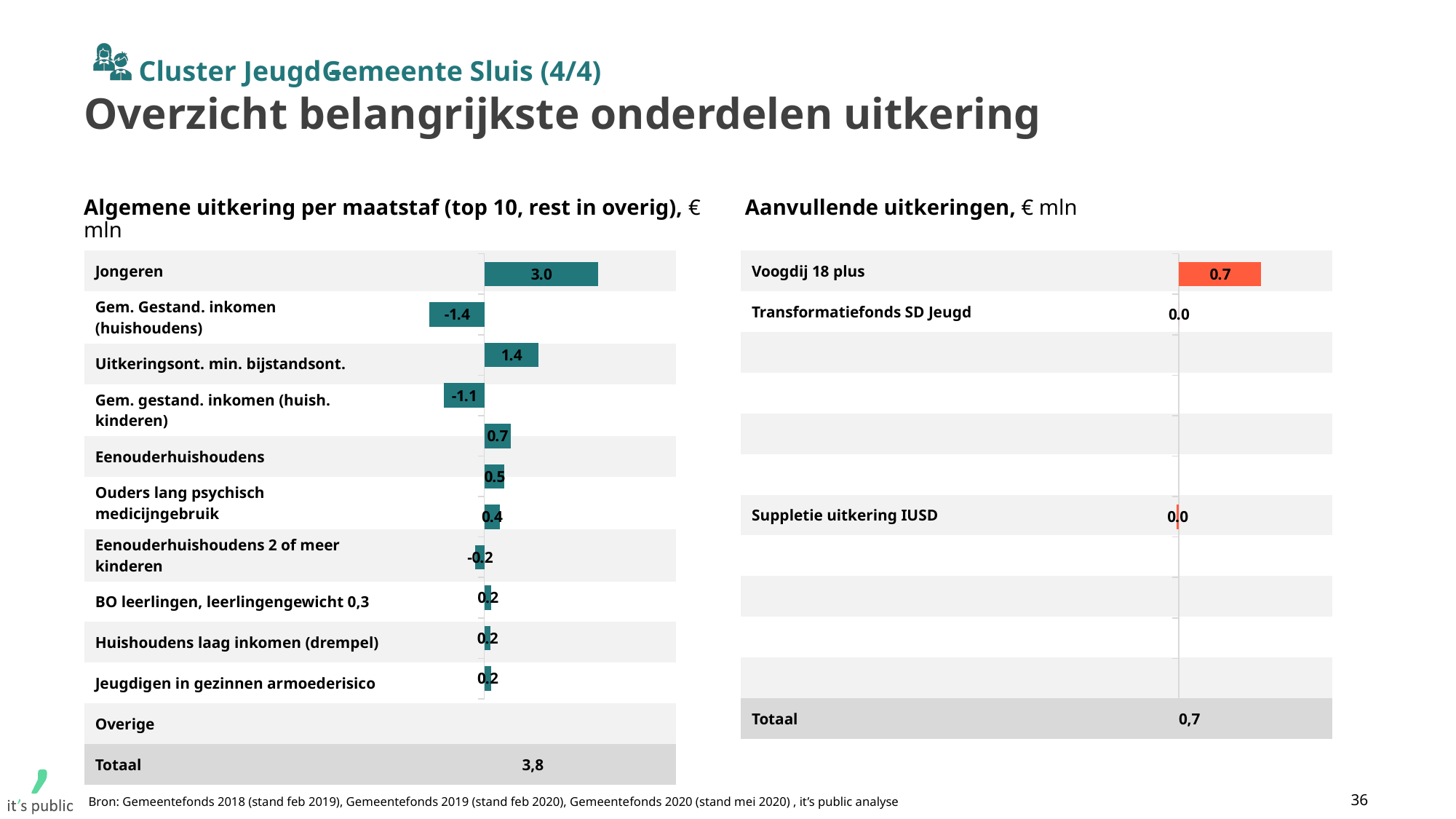
In the chart 'Algemene uitkering per maatstaf', what is the Totaal shown at the bottom? 3,8 In the chart 'Algemene uitkering per maatstaf', what is the value for Jongeren? 3.0 In the chart 'Algemene uitkering per maatstaf', what is the value for Gem. Gestand. inkomen (huishoudens)? -1.4 In the chart 'Algemene uitkering per maatstaf', what is the value for Uitkeringsont. min. bijstandsont.? 1.4 In the chart 'Aanvullende uitkeringen', what is the value for Voogdij 18 plus? 0.7 In the chart 'Aanvullende uitkeringen', what is the value for Transformatiefonds SD Jeugd? 0.0 In the chart 'Algemene uitkering per maatstaf', which category has the highest value? Jongeren In the chart 'Aanvullende uitkeringen', what is the Totaal shown at the bottom? 0,7 In the chart 'Algemene uitkering per maatstaf', what is the value for Gem. gestand. inkomen (huish. kinderen)? -1.1 In the chart 'Algemene uitkering per maatstaf', which category has the lowest value? Gem. Gestand. inkomen (huishoudens) What kind of chart is 'Aanvullende uitkeringen'? Bar chart In the chart 'Algemene uitkering per maatstaf', what is the difference between the values for Jongeren and Uitkeringsont. min. bijstandsont.? 1.6